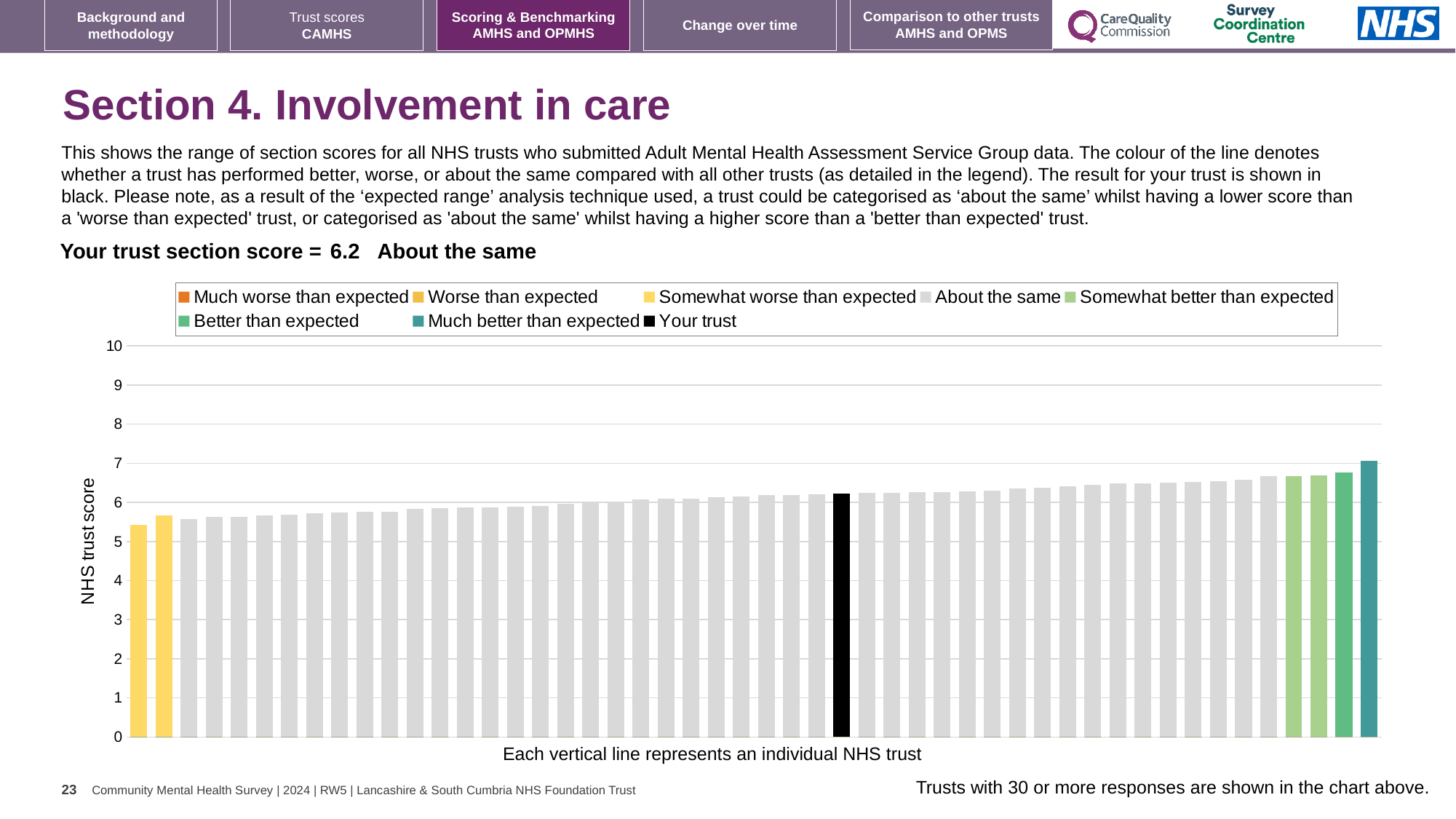
Is the value of the shortest bar (the leftmost trust) greater or less than 6? less What is the section score for your trust? 6.2 How many entries does the chart legend list? 8 Do the trust scores rise or fall moving from left to right along the x axis? rise Is the value of the leftmost bar greater or less than 5? greater Which is larger, the leftmost bar or the rightmost bar? the rightmost bar Which legend category does the highest-scoring trust belong to? Much better than expected Which performance category is your trust placed in for this section? About the same Is the value of the tallest bar (the rightmost trust) greater or less than 6? greater What colour is the bar representing your trust? black What kind of chart is shown on the slide? bar chart